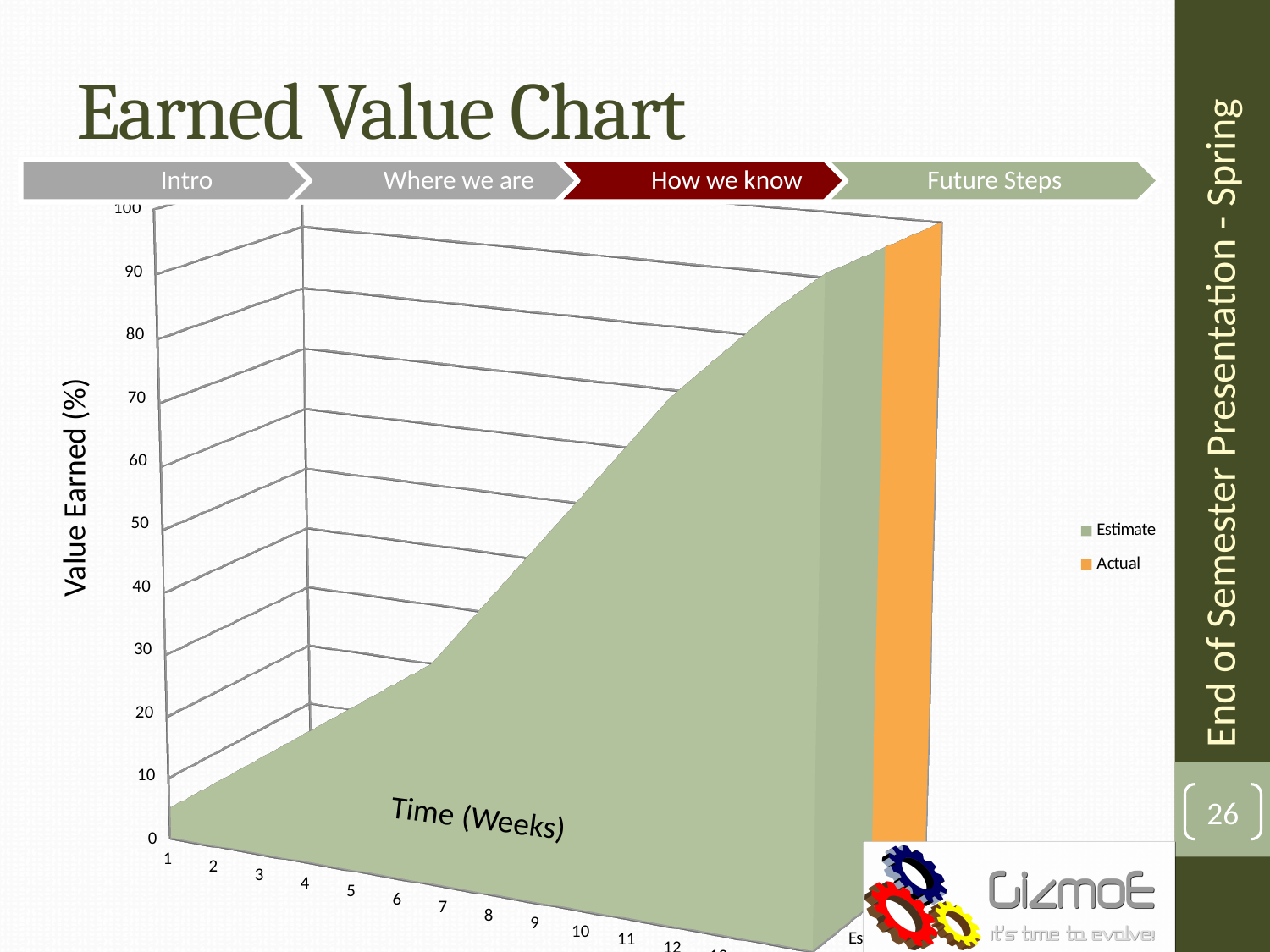
Is the Estimate value at week 10 greater or less than 30? greater Is the Estimate value larger at week 2 or at week 11? Week 11 What kind of chart is shown on the slide? Area chart What are the two series named in the legend? Estimate and Actual How many series does the legend list? 2 Is the Estimate value at week 3 greater or less than 40? less Is the Estimate value at week 1 greater or less than 50? less What is the title of the chart? Earned Value Chart Does the Estimate series rise or fall as the weeks increase? Rise Which week has the lowest Estimate value? 1